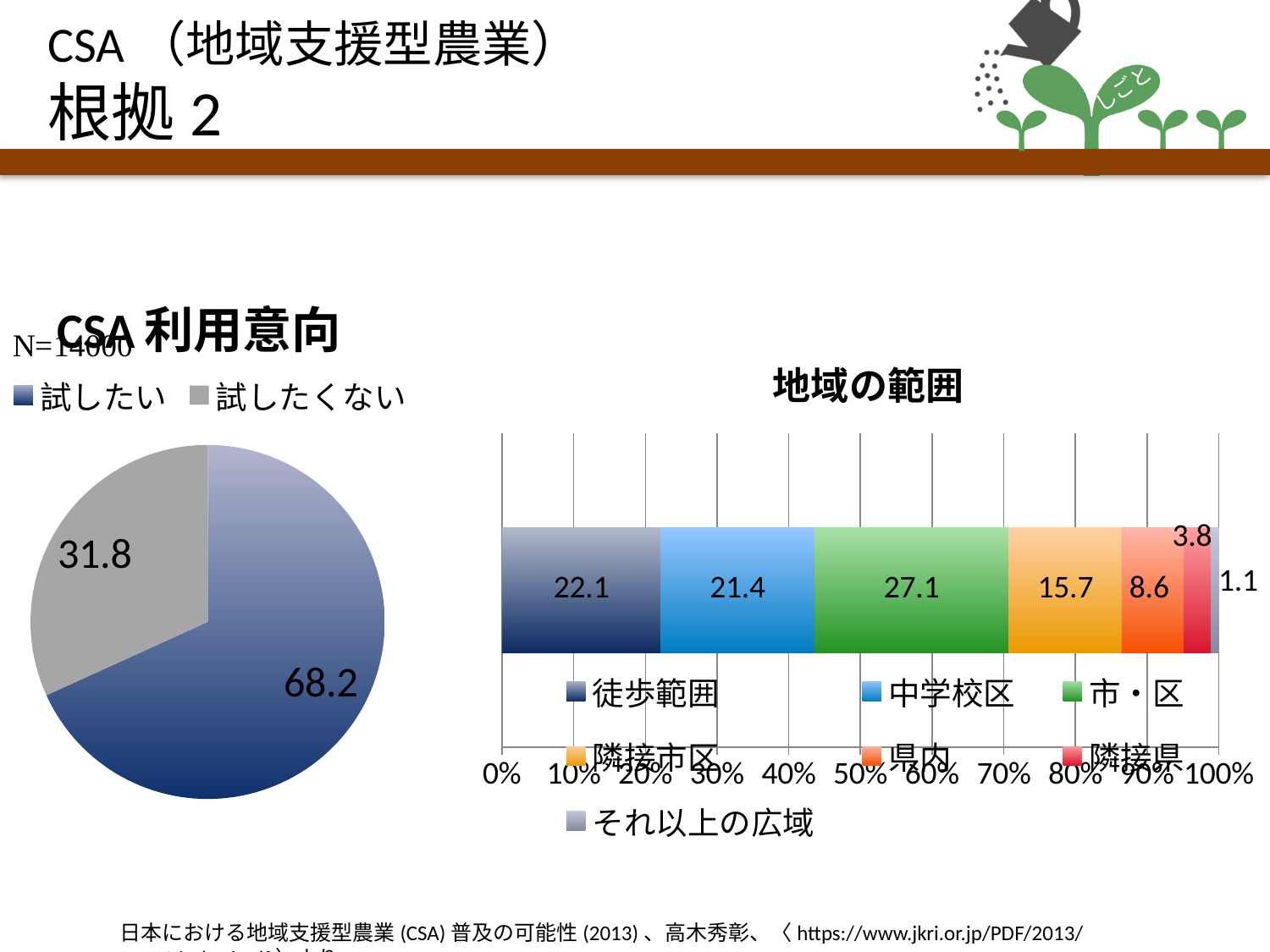
In the 地域の範囲 chart, what is the value for 徒歩範囲? 22.1 In the CSA 利用意向 pie chart, which slice is larger, 試したい or 試したくない? 試したい In the 地域の範囲 chart, what is the difference between 隣接市区 and 県内? 7.1 How many series does the legend of the 地域の範囲 chart list? 7 In the 地域の範囲 chart, which segment has the highest value? 市・区 In the CSA 利用意向 pie chart, what is the difference between 試したい and 試したくない? 36.4 In the 地域の範囲 chart, which segment has the lowest value? それ以上の広域 In the CSA 利用意向 pie chart, what is the value for 試したい? 68.2 What kind of chart is the CSA 利用意向 chart on the left? pie chart In the 地域の範囲 chart, what is the value for 市・区? 27.1 What kind of chart is the 地域の範囲 chart on the right? stacked bar chart In the CSA 利用意向 pie chart, what is the value for 試したくない? 31.8